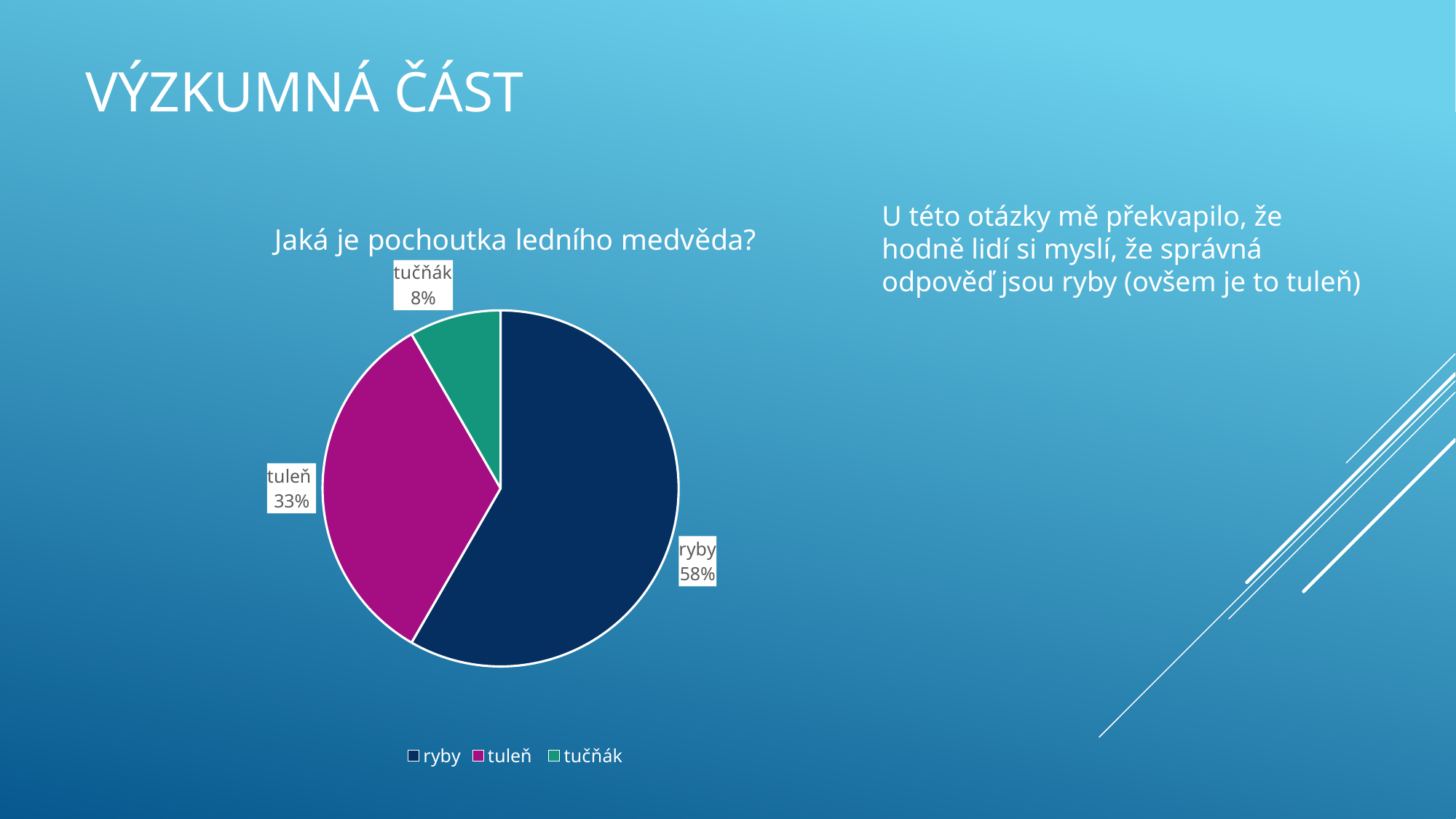
Which category has the largest slice of the pie? ryby What is the difference in percentage points between the 'ryby' and 'tuleň' slices? 25 Which slice is larger, 'tuleň' or 'tučňák'? tuleň Which category is shown in the magenta colour? tuleň What share of the pie does the 'tuleň' slice represent? 33% What share of the pie does the 'ryby' slice represent? 58% What is the title of the chart? Jaká je pochoutka ledního medvěda? What share of the pie does the 'tučňák' slice represent? 8% How many categories does the pie chart have? 3 What is the difference in percentage points between the 'tuleň' and 'tučňák' slices? 25 What kind of chart is shown on the slide? pie chart Which category has the smallest slice of the pie? tučňák